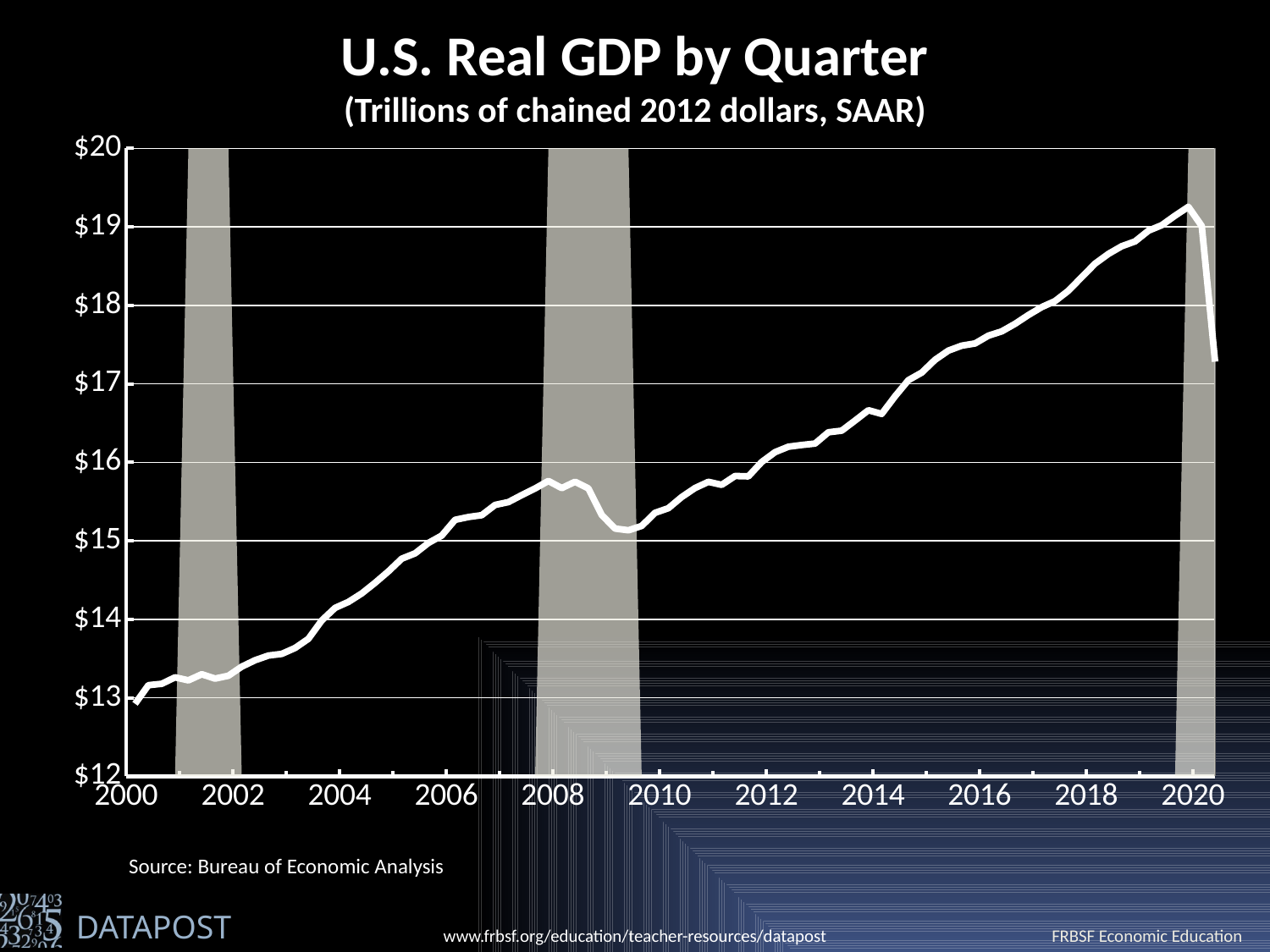
Overall, does real GDP rise or fall from 2000 to the peak near 2020? rise What is the title of the chart? U.S. Real GDP by Quarter In what units are the values on the chart expressed, according to the subtitle? Trillions of chained 2012 dollars, SAAR Is the highest value on the line, reached just before 2020, greater or less than $19? greater Is the value for 2010 greater or less than $15? greater What is the highest value shown on the vertical axis? $20 Is the final value at the end of the line in 2020 greater or less than $18? less Which is larger, the value for 2018 or the value for 2012? 2018 What kind of chart is shown on the slide? line chart